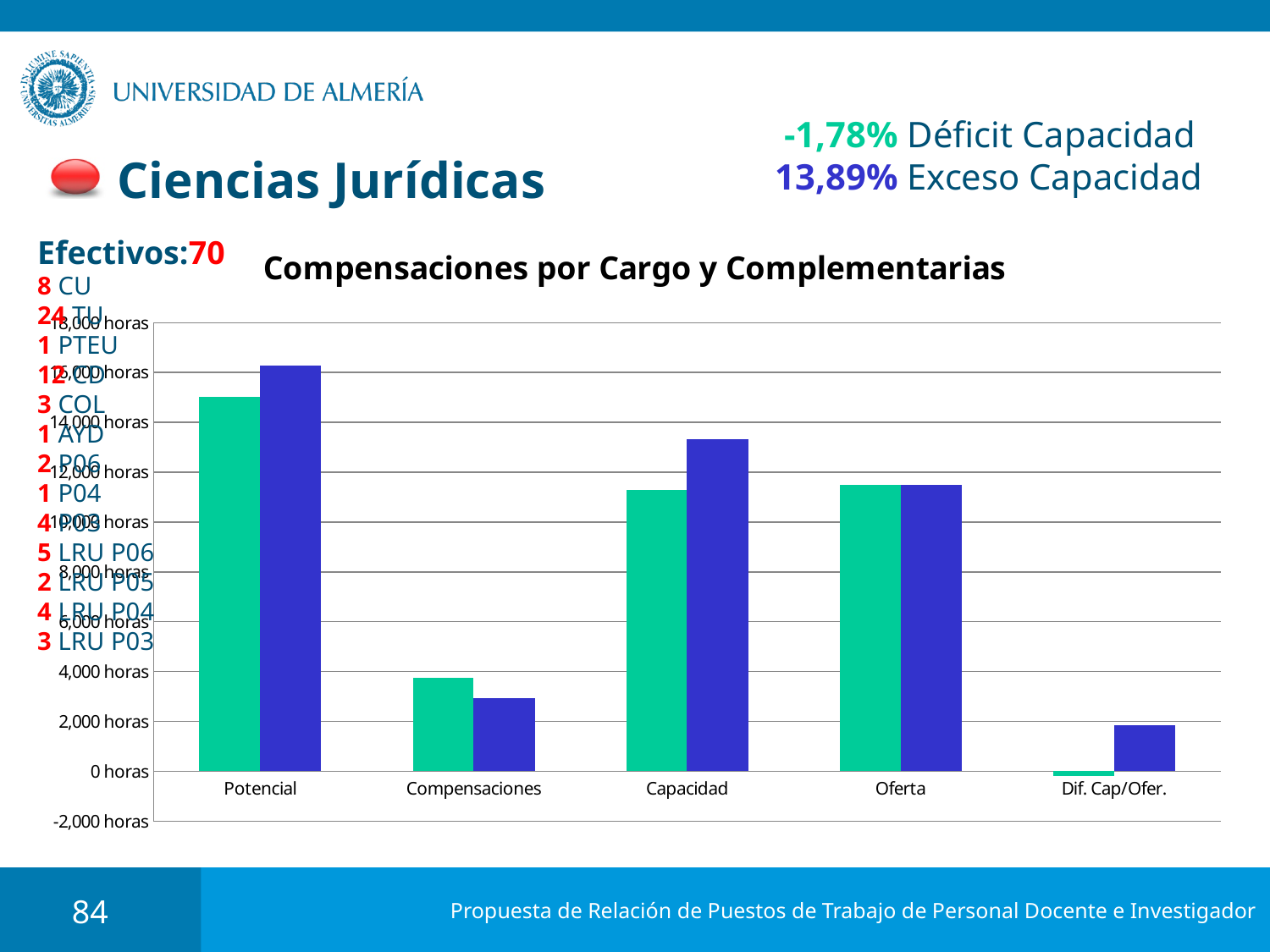
For Compensaciones, which bar is taller, the green one or the blue one? the green one Which category has the lowest bars in the chart? Dif. Cap/Ofer. Is the blue bar for Capacidad greater or less than 12,000 horas? greater What is the title of the chart? Compensaciones por Cargo y Complementarias For Capacidad, which bar is taller, the green one or the blue one? the blue one What kind of chart is shown on the slide? bar chart Is the blue bar for Potencial greater or less than 16,000 horas? greater Is the green bar for Compensaciones greater or less than 4,000 horas? less How many categories are shown on the x axis of the chart? 5 Which category has the tallest bars in the chart? Potencial